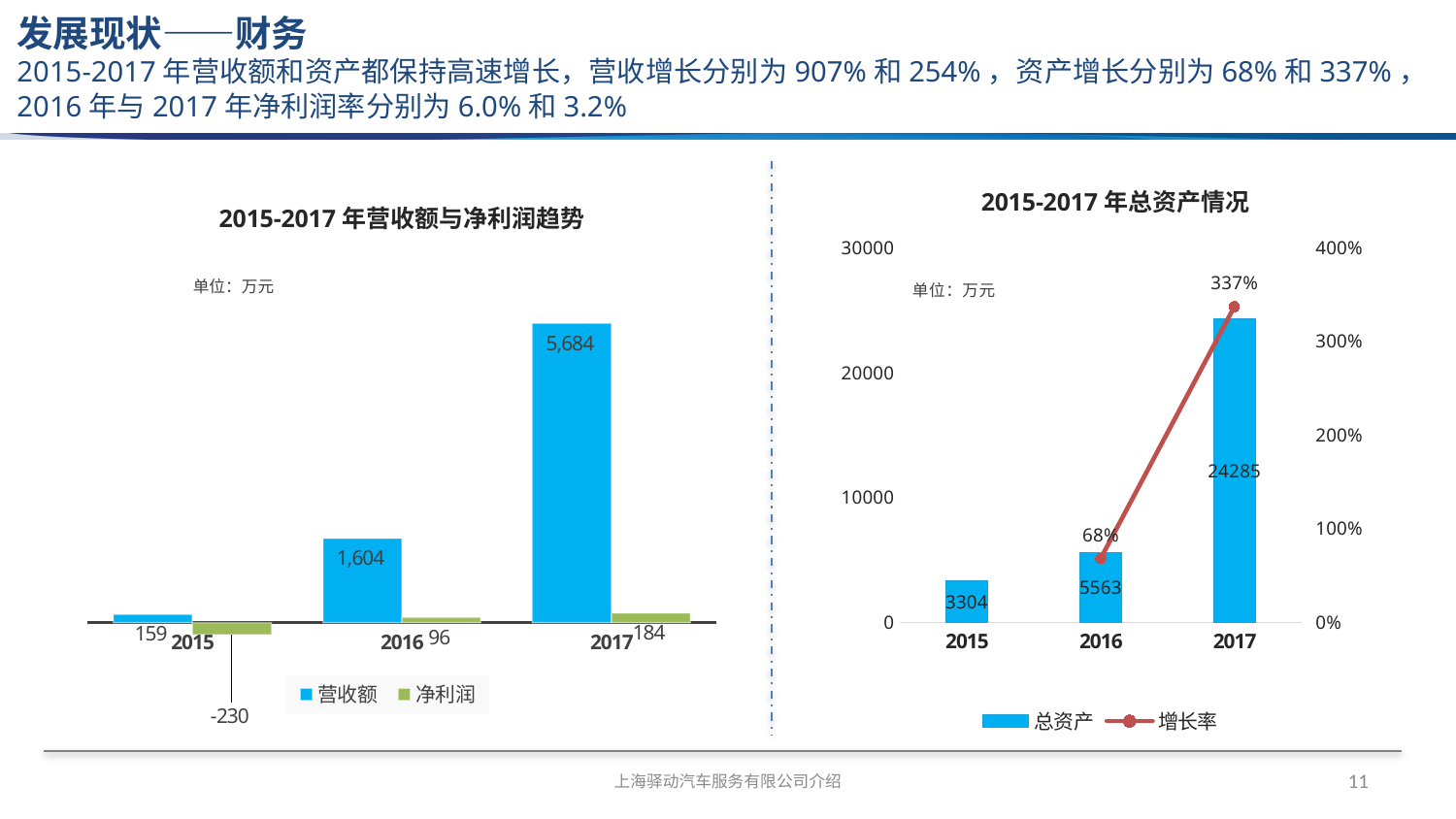
In the chart titled 2015-2017年总资产情况, how many years are shown on the x axis? 3 In the chart titled 2015-2017年总资产情况, what is the 总资产 value for 2017? 24285 In the chart titled 2015-2017年营收额与净利润趋势, what is the 营收额 value for 2017? 5,684 In the chart titled 2015-2017年营收额与净利润趋势, what is the 净利润 value for 2015? -230 In the chart titled 2015-2017年营收额与净利润趋势, what is the difference between the 营收额 values for 2017 and 2016? 4,080 In the chart titled 2015-2017年总资产情况, what is the difference between the 总资产 values for 2016 and 2015? 2259 In the chart titled 2015-2017年营收额与净利润趋势, do the 营收额 values rise or fall from 2015 to 2017? rise In the chart titled 2015-2017年总资产情况, what is the 增长率 value for 2016? 68% In the chart titled 2015-2017年营收额与净利润趋势, which year has the lowest 净利润? 2015 In the chart titled 2015-2017年营收额与净利润趋势, how many series does the legend list? 2 In the chart titled 2015-2017年总资产情况, which year has the highest 总资产? 2017 In the chart titled 2015-2017年总资产情况, what unit is stated for the values? 万元